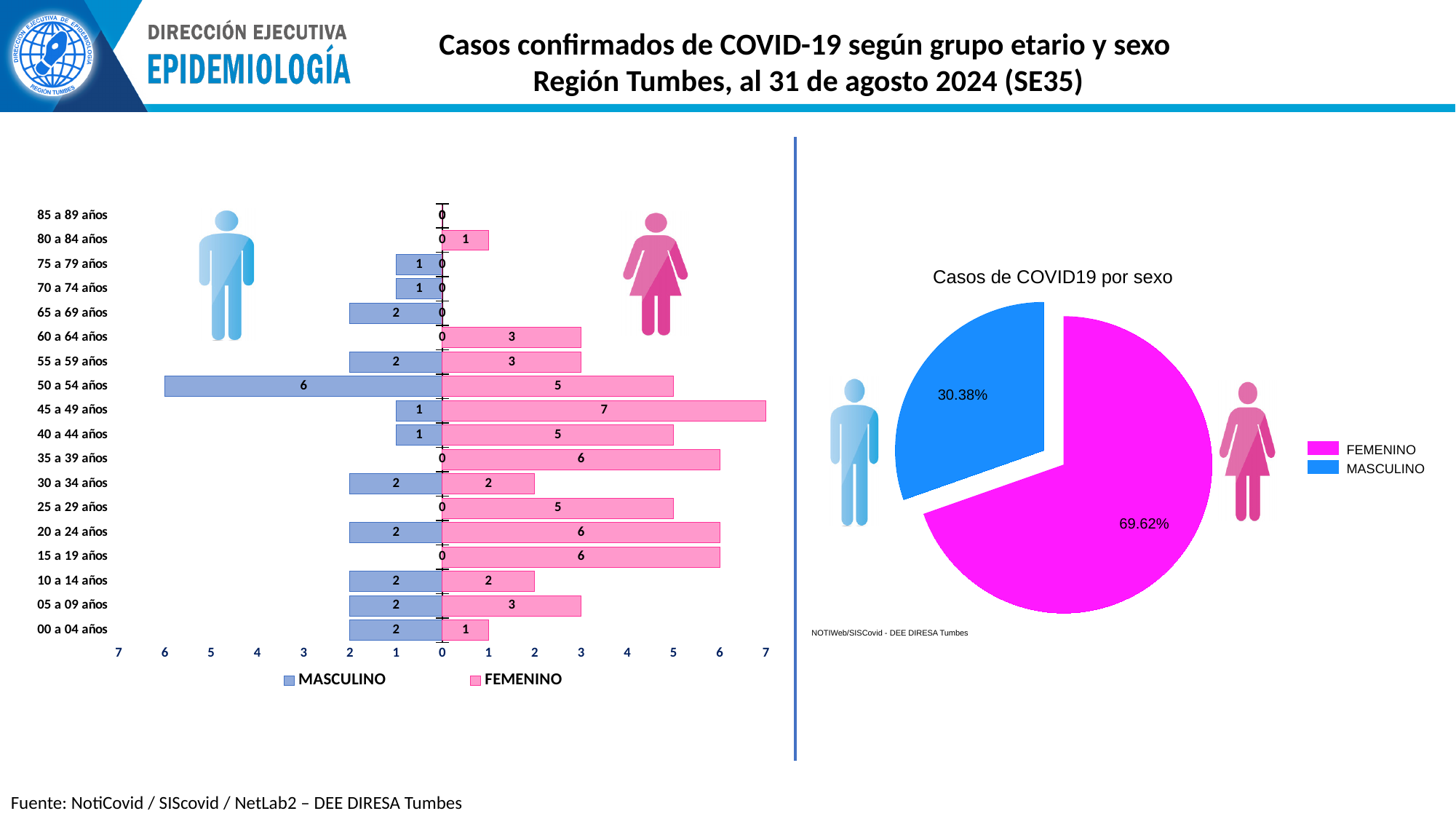
In the left chart, how many MASCULINO cases are in the 50 a 54 años group? 6 What kind of chart is the left chart? Bar chart In the left chart, which age group has the highest FEMENINO value? 45 a 49 años In the pie chart 'Casos de COVID19 por sexo', what share is MASCULINO? 30.38% In the left chart, which age group has the highest MASCULINO value? 50 a 54 años In the left chart, what is the difference between the FEMENINO and MASCULINO values for the 20 a 24 años group? 4 In the left chart, how many series does the legend list? 2 In the left chart, how many age groups are shown? 18 In the pie chart 'Casos de COVID19 por sexo', which colour represents MASCULINO? Blue In the left chart, which is larger for the 50 a 54 años group, MASCULINO or FEMENINO? MASCULINO In the pie chart 'Casos de COVID19 por sexo', what share is FEMENINO? 69.62% In the left chart, how many FEMENINO cases are in the 45 a 49 años group? 7